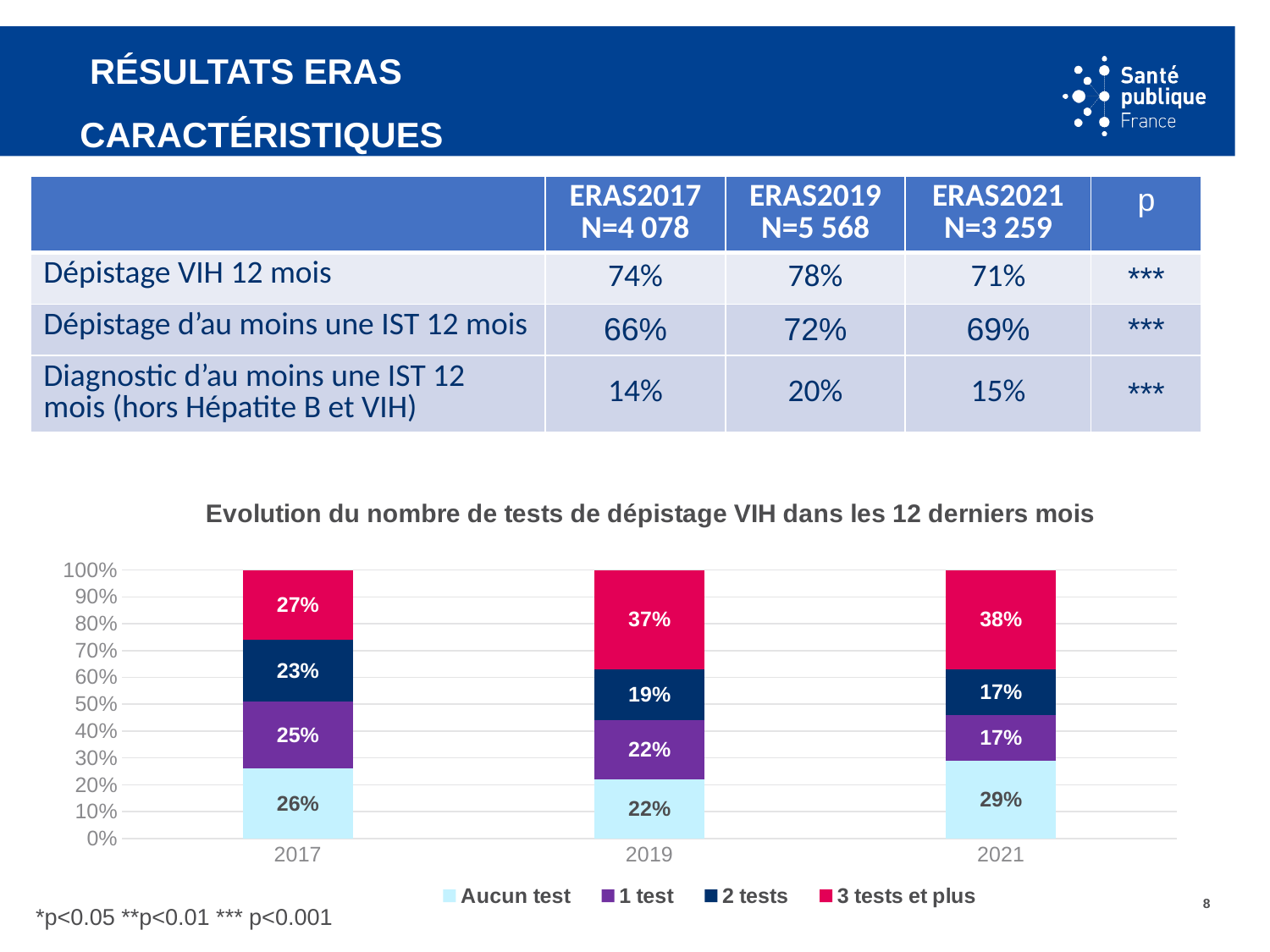
What is the value for "3 tests et plus" in 2021? 38% In which year is the "3 tests et plus" share the lowest? 2017 How many years are shown on the x axis of the chart? 3 Which is larger: the "2 tests" value in 2017 or in 2019? 2017 What is the value for "1 test" in 2017? 25% What kind of chart is shown on the slide? Stacked bar chart Does the "2 tests" share rise or fall from 2017 to 2021? Fall What is the difference between the "3 tests et plus" values for 2019 and 2017? 10% What is the value for "2 tests" in 2021? 17% How many series does the chart legend list? 4 In which year is the "Aucun test" share the highest? 2021 What is the value for "Aucun test" in 2019? 22%